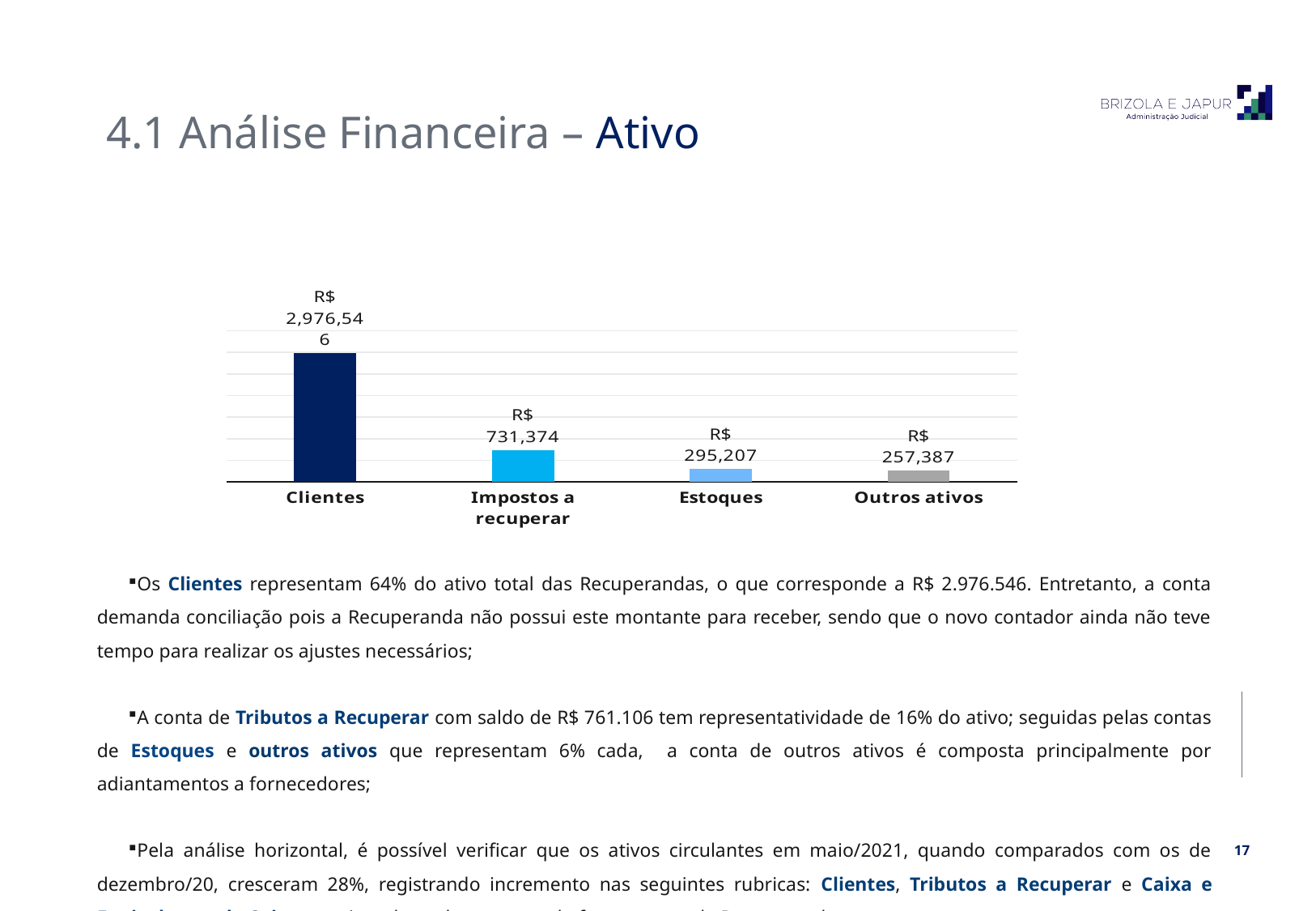
What is the value shown for Impostos a recuperar? R$ 731,374 Which category has the lowest value? Outros ativos Do the values rise or fall from left to right across the categories? Fall How many categories are shown in the chart? 4 Which is larger, the value for Impostos a recuperar or the value for Estoques? Impostos a recuperar What kind of chart is shown on the slide? Bar chart What is the difference between the values for Estoques and Outros ativos? R$ 37,820 What is the difference between the values for Clientes and Impostos a recuperar? R$ 2,245,172 What is the value shown for Estoques? R$ 295,207 Which category has the highest value? Clientes What is the value shown for Outros ativos? R$ 257,387 What is the value shown for Clientes? R$ 2,976,546